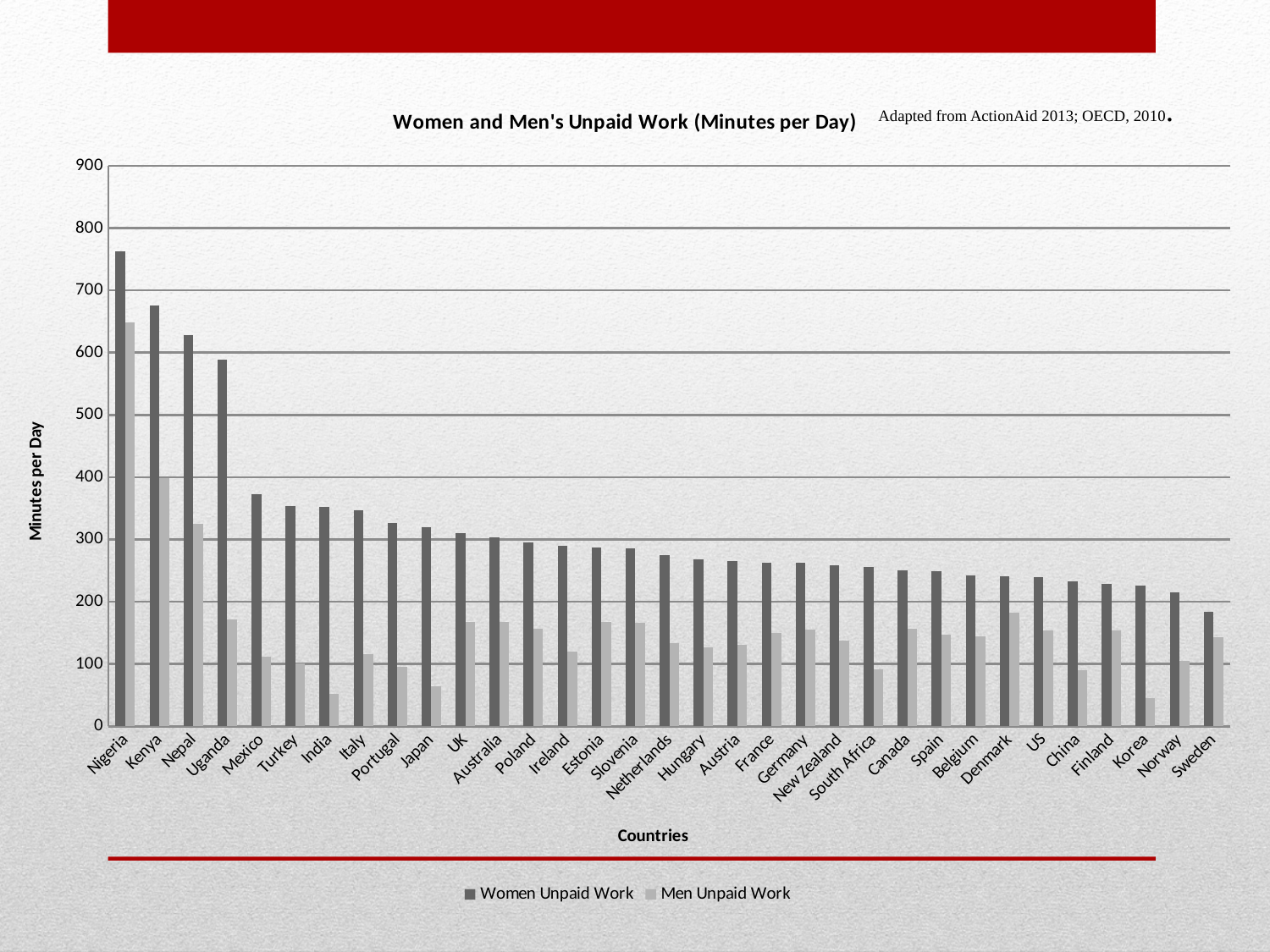
Is the Women Unpaid Work value for Nigeria greater or less than 700? greater Is the Men Unpaid Work value for Japan greater or less than 100? less What kind of chart is shown on the slide? Bar chart Which country has the highest value for Men Unpaid Work? Nigeria How many countries are shown on the x axis? 33 Do the Women Unpaid Work values rise or fall from left to right along the x axis? Fall Which country has the highest value for Women Unpaid Work? Nigeria Is the Men Unpaid Work value for Kenya greater or less than 300? greater Which country has the lowest value for Women Unpaid Work? Sweden Which is larger, the Men Unpaid Work value for Nepal or for Uganda? Nepal How many series does the legend list? 2